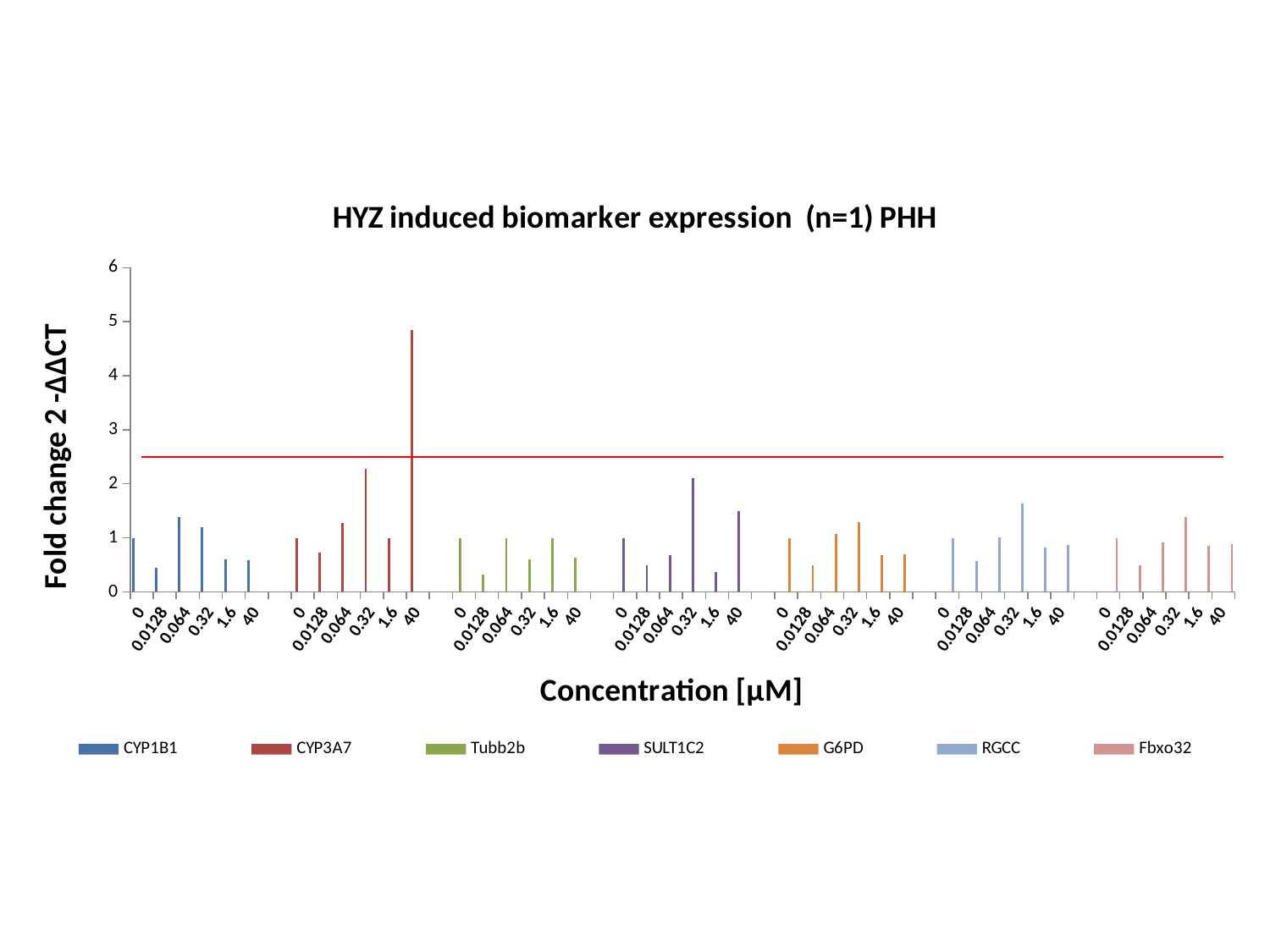
Is the value for CYP3A7 at concentration 40 greater or less than 4? greater Is the value for CYP3A7 at concentration 0.32 greater or less than 3? less How many concentration levels are plotted for each series? 6 What is the label of the x axis? Concentration [µM] Which is larger: the value for CYP3A7 at concentration 40 or the value for SULT1C2 at concentration 0.32? CYP3A7 at 40 Is the value for RGCC at concentration 0.32 greater or less than 1? greater What kind of chart is shown on the slide? bar chart What is the title of the chart? HYZ induced biomarker expression (n=1) PHH At which concentration does CYP3A7 reach its highest value? 40 Which series contains the highest bar on the chart? CYP3A7 How many series does the legend list? 7